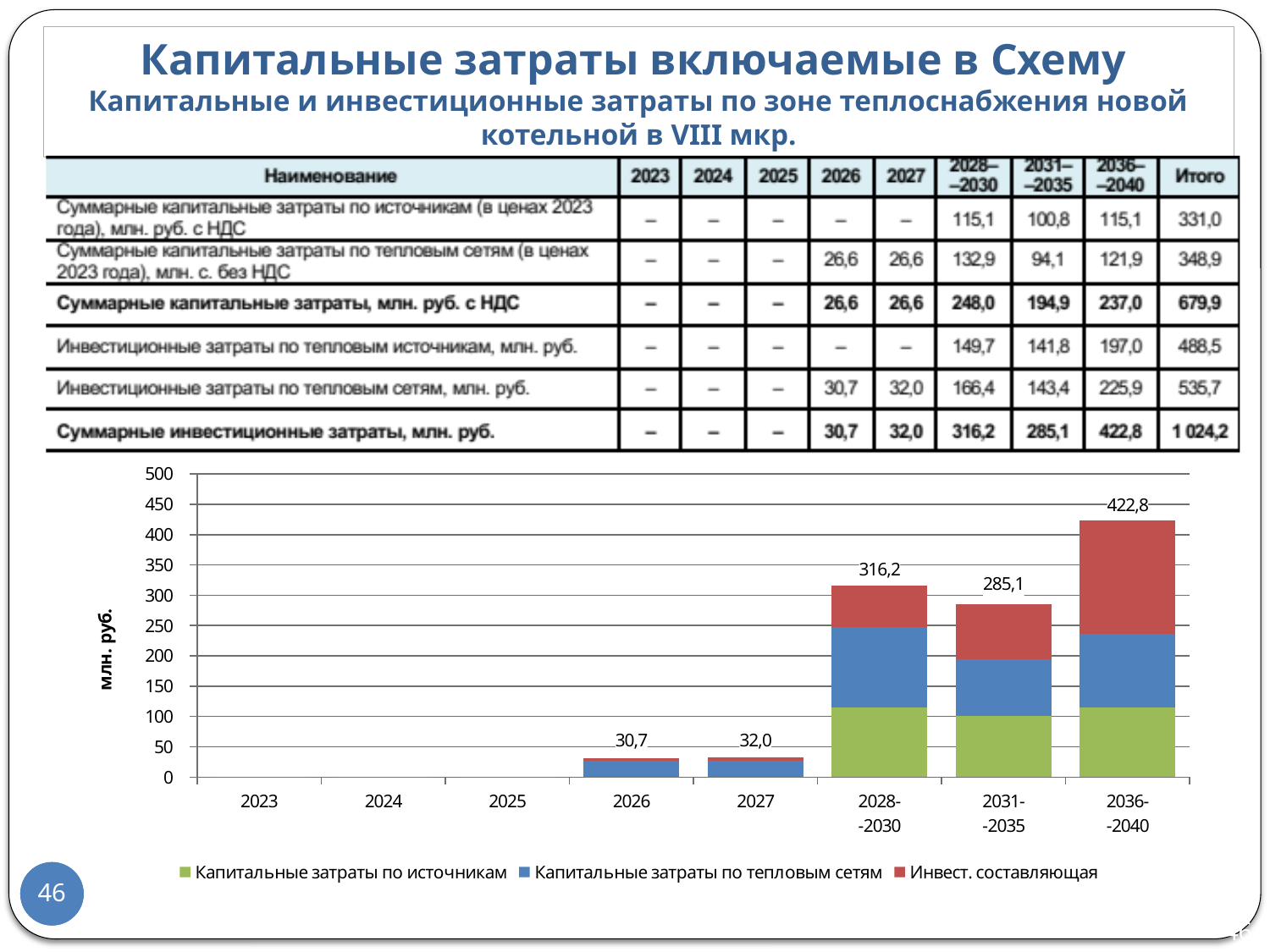
What is the total value labelled on the bar for 2036-2040? 422,8 Which period has the highest total bar in the chart? 2036-2040 Is the total value for 2031-2035 greater or less than 300? less What is the label of the y axis of the chart? млн. руб. How many series does the chart legend list? 3 Which of the labelled bars has the lowest total value? 2026 Which total is larger, 2028-2030 or 2031-2035? 2028-2030 How many categories are shown on the x axis of the chart? 8 What type of chart is shown on the slide? stacked bar chart What is the difference between the total for 2036-2040 and the total for 2031-2035? 137,7 What is the total value labelled on the bar for 2026? 30,7 What is the total value labelled on the bar for 2028-2030? 316,2